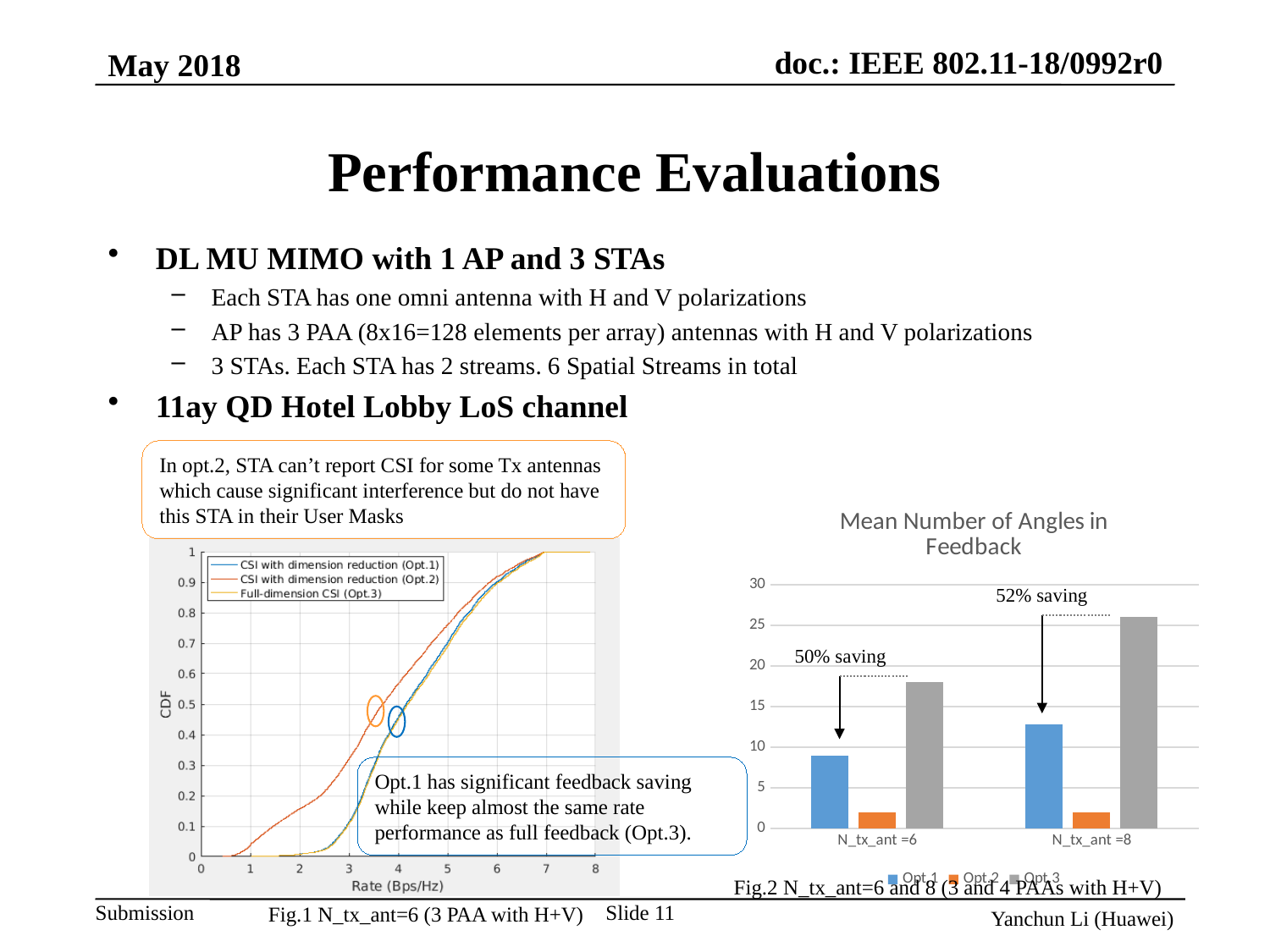
In the 'Mean Number of Angles in Feedback' chart, is the Opt.3 value for N_tx_ant =8 greater or less than 25? greater How many series does the legend of the 'Mean Number of Angles in Feedback' chart list? 3 How many series does the legend of the Fig.1 line chart list? 3 In the 'Mean Number of Angles in Feedback' chart, which series has the highest value for N_tx_ant =8? Opt.3 What kind of chart is Fig.1 on the left of the slide? line chart How many categories are shown on the x axis of the 'Mean Number of Angles in Feedback' chart? 2 In the 'Mean Number of Angles in Feedback' chart, is the Opt.1 value for N_tx_ant =6 greater or less than 10? less In the 'Mean Number of Angles in Feedback' chart, is the Opt.3 value for N_tx_ant =6 greater or less than 15? greater In the 'Mean Number of Angles in Feedback' chart, which is larger: Opt.1 for N_tx_ant =6 or Opt.1 for N_tx_ant =8? Opt.1 for N_tx_ant =8 In the 'Mean Number of Angles in Feedback' chart, which series has the lowest value for N_tx_ant =6? Opt.2 What kind of chart is the 'Mean Number of Angles in Feedback' chart? bar chart In the 'Mean Number of Angles in Feedback' chart, does the Opt.3 value rise or fall from N_tx_ant =6 to N_tx_ant =8? rise